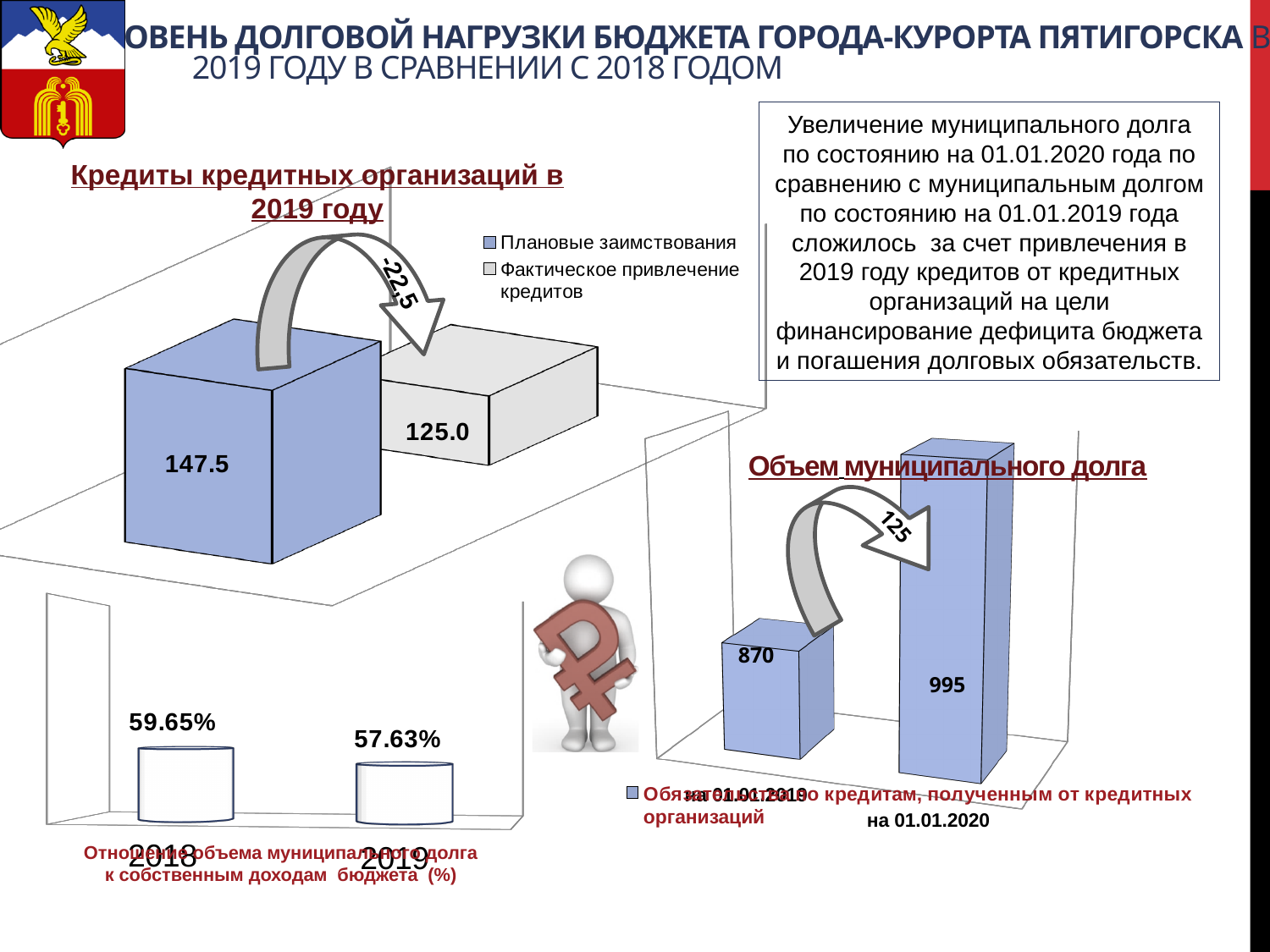
In the bottom-left chart 'Отношение объема муниципального долга к собственным доходам бюджета (%)', which year has the higher value? 2018 In the chart 'Объем муниципального долга', what is the value на 01.01.2019? 870 In the chart 'Объем муниципального долга', what is the value на 01.01.2020? 995 In the chart 'Объем муниципального долга', does the value rise or fall from 01.01.2019 to 01.01.2020? rise In the chart 'Кредиты кредитных организаций в 2019 году', what is the value for Плановые заимствования? 147.5 In the chart 'Кредиты кредитных организаций в 2019 году', what is the difference between Плановые заимствования and Фактическое привлечение кредитов? 22.5 How many series does the legend of the chart 'Кредиты кредитных организаций в 2019 году' list? 2 In the chart 'Кредиты кредитных организаций в 2019 году', which is larger: Плановые заимствования or Фактическое привлечение кредитов? Плановые заимствования In the bottom-left chart 'Отношение объема муниципального долга к собственным доходам бюджета (%)', what is the value for 2018? 59.65% In the chart 'Кредиты кредитных организаций в 2019 году', what is the value for Фактическое привлечение кредитов? 125.0 In the chart 'Объем муниципального долга', by how much did the value increase from 01.01.2019 to 01.01.2020? 125 In the bottom-left chart 'Отношение объема муниципального долга к собственным доходам бюджета (%)', what is the value for 2019? 57.63%